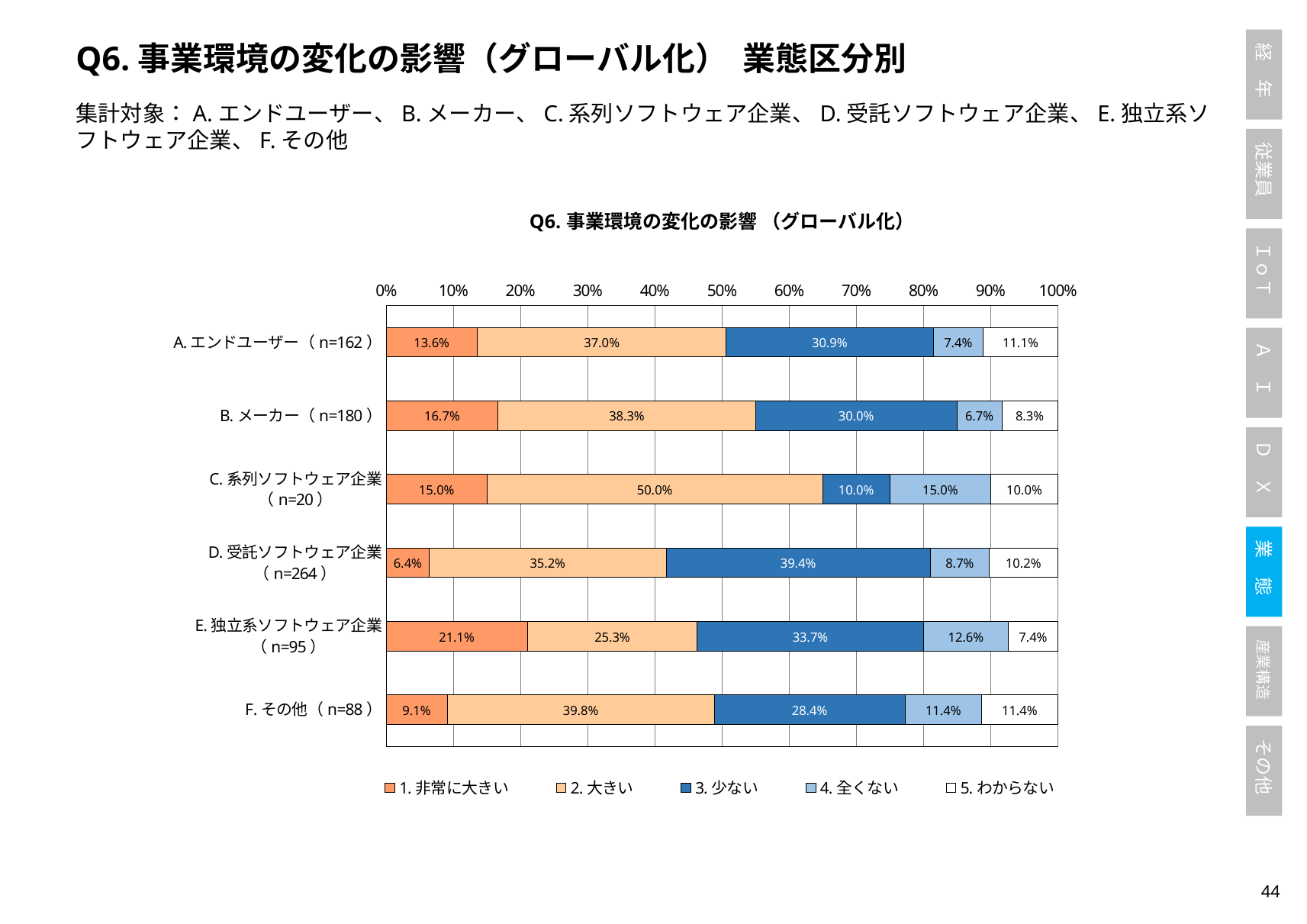
Which category has the lowest value for 「3. 少ない」? C. 系列ソフトウェア企業 What is the value of 「2. 大きい」 for C. 系列ソフトウェア企業? 50.0% What type of chart is shown on the slide? Stacked bar chart Which category has the highest value for 「1. 非常に大きい」? E. 独立系ソフトウェア企業 Which is larger: the 「4. 全くない」 value for E. 独立系ソフトウェア企業 or for F. その他? E. 独立系ソフトウェア企業 What is the value of 「1. 非常に大きい」 for D. 受託ソフトウェア企業? 6.4% What is the difference between the 「3. 少ない」 values for D. 受託ソフトウェア企業 and A. エンドユーザー? 8.5% What is the combined share of 「1. 非常に大きい」 and 「2. 大きい」 for B. メーカー? 55.0% What is the sample size (n) shown for D. 受託ソフトウェア企業? 264 What is the value of 「5. わからない」 for B. メーカー? 8.3% How many categories (業態区分) are plotted on the chart? 6 How many series does the legend list? 5